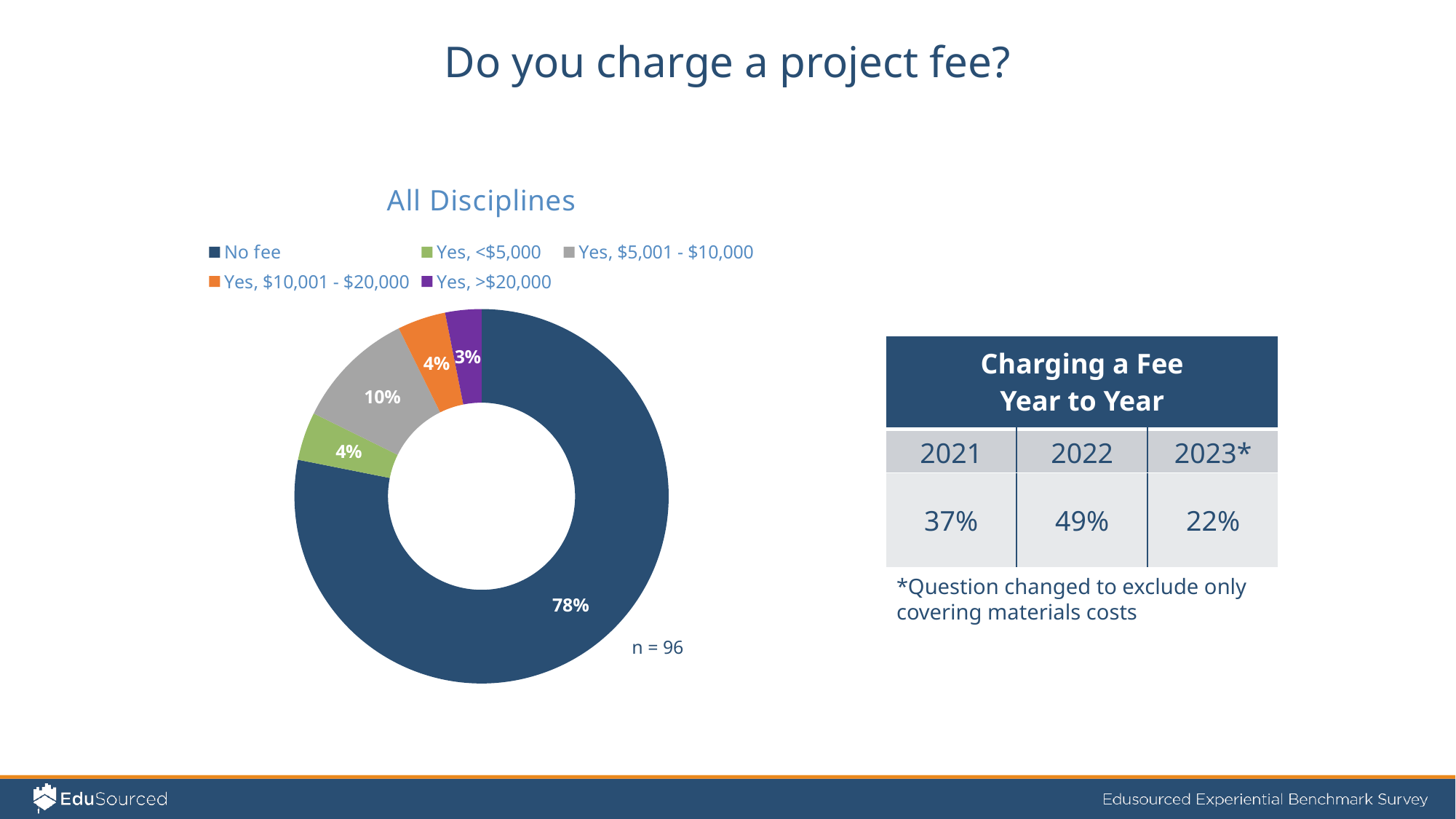
In the All Disciplines chart, what is the difference in percentage points between 'No fee' and 'Yes, $5,001 - $10,000'? 68 In the All Disciplines chart, what percentage charge a fee of less than $5,000? 4% Which category has the smallest slice in the All Disciplines chart? Yes, >$20,000 In the All Disciplines chart, what percentage charge a fee of more than $20,000? 3% What is the sample size (n) noted next to the All Disciplines chart? n = 96 Which category has the largest slice in the All Disciplines chart? No fee In the All Disciplines chart, what share of respondents charge a fee of $5,001 - $10,000? 10% How many categories are shown in the All Disciplines chart? 5 How many entries does the legend of the All Disciplines chart list? 5 What percentage of respondents in the All Disciplines chart charge no fee? 78% What type of chart is the All Disciplines chart? Pie chart (donut) In the All Disciplines chart, which is larger: the share for 'Yes, $5,001 - $10,000' or the share for 'Yes, >$20,000'? Yes, $5,001 - $10,000